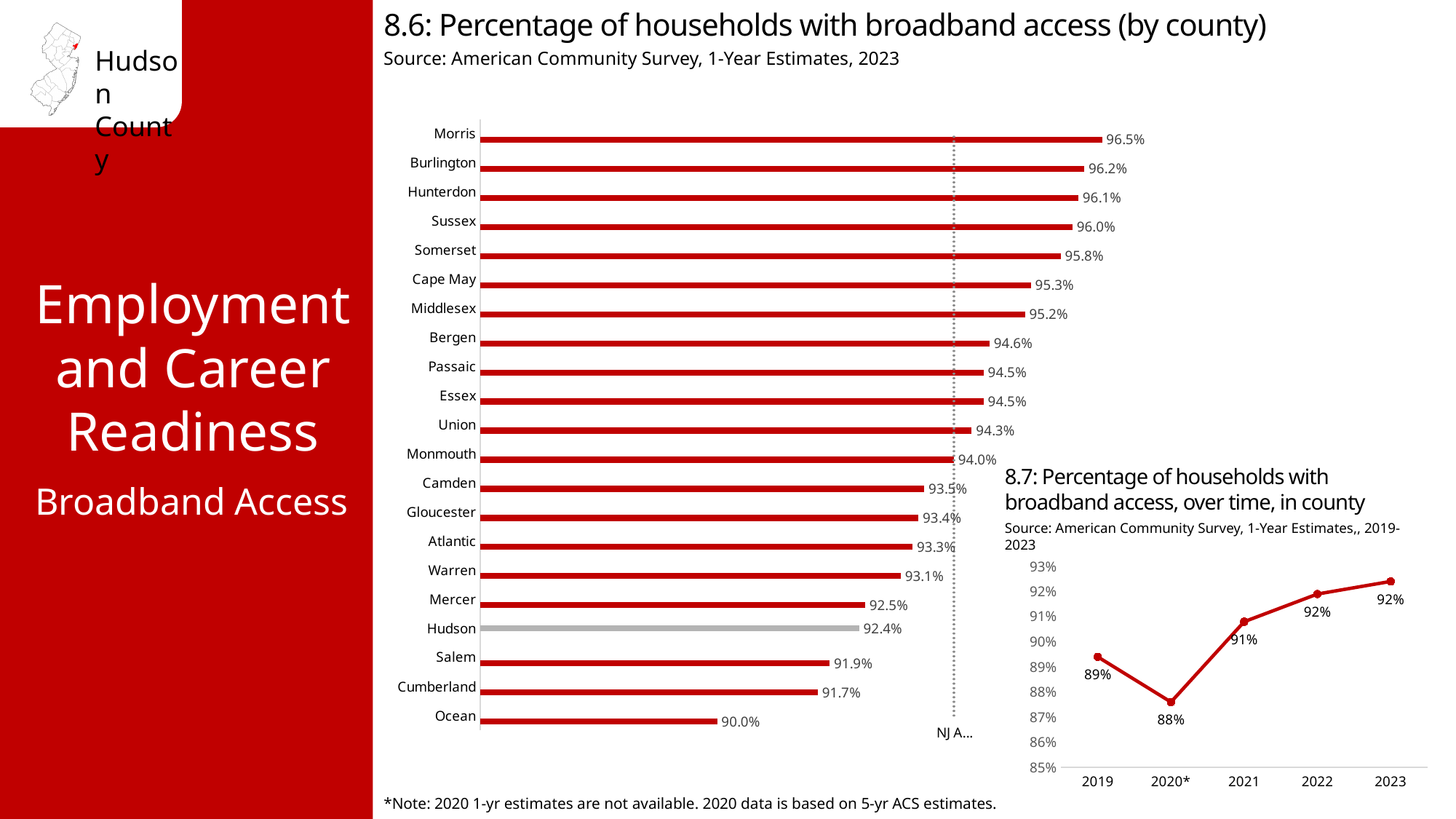
In chart 8.7, which year has the lowest value? 2020* What kind of chart is chart 8.6? Bar chart In chart 8.6, what is the difference between the values for Morris and Ocean? 6.5 percentage points In chart 8.6, how many counties are shown? 21 In chart 8.6, which county has the highest percentage of households with broadband access? Morris In chart 8.7, do the values rise or fall from 2020* to 2023? Rise In chart 8.6, what is the value for Cumberland? 91.7% In chart 8.6 (Percentage of households with broadband access by county), what is the value for Hudson? 92.4% In chart 8.6, which has a higher value, Mercer or Hudson? Mercer In chart 8.7 (broadband access over time in county), what is the value for 2020*? 88% In chart 8.6, which county has the lowest percentage of households with broadband access? Ocean In chart 8.7, how many data points are plotted? 5